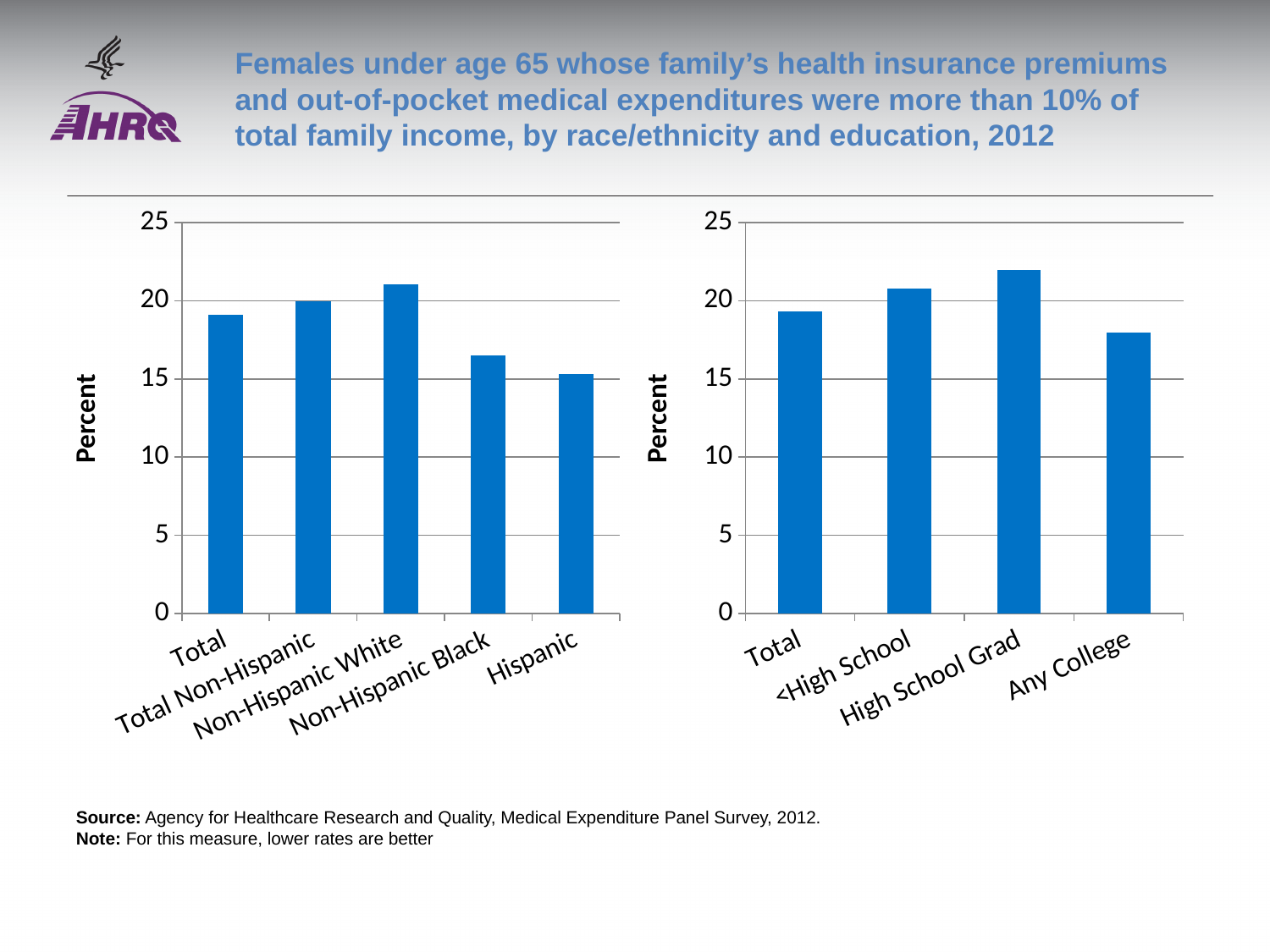
On the right chart (by education), is the value for Any College greater or less than 20? less On the left chart (by race/ethnicity), which is larger, the value for Non-Hispanic Black or the value for Hispanic? Non-Hispanic Black On the left chart (by race/ethnicity), which category has the lowest value? Hispanic On the right chart (by education), which category has the highest value? High School Grad On the right chart (by education), which is larger, the value for High School Grad or the value for Any College? High School Grad On the left chart (by race/ethnicity), is the value for Non-Hispanic Black greater or less than 20? less What kind of chart is the right chart (by education)? bar chart On the right chart (by education), which category has the lowest value? Any College How many categories are shown on the left chart (by race/ethnicity)? 5 On the left chart (by race/ethnicity), is the value for Non-Hispanic Black greater or less than 15? greater On the left chart (by race/ethnicity), which category has the highest value? Non-Hispanic White